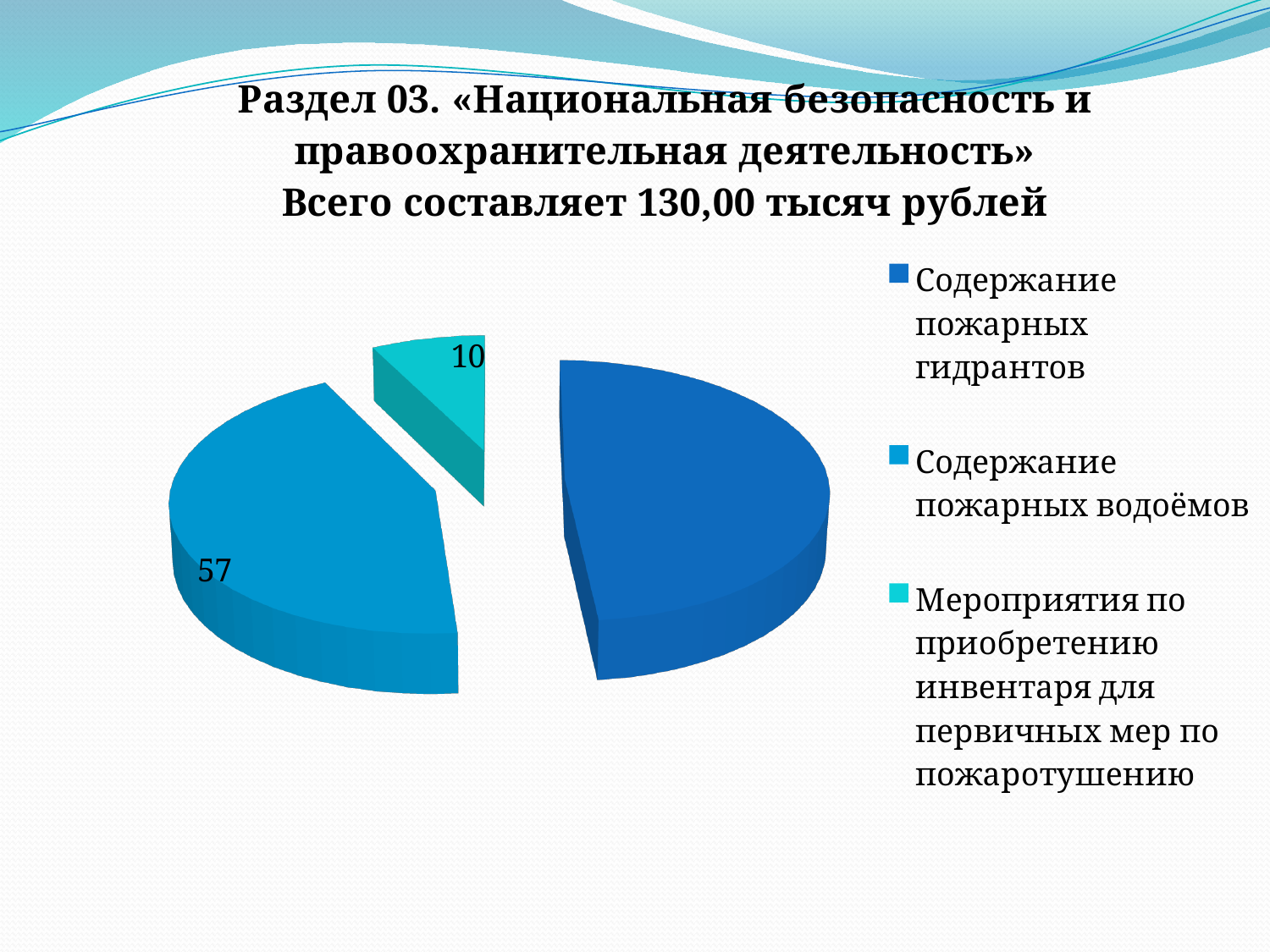
What is the value shown for Содержание пожарных водоёмов? 57 Which is larger: the slice for Содержание пожарных гидрантов or the slice for Мероприятия по приобретению инвентаря для первичных мер по пожаротушению? Содержание пожарных гидрантов What is the value shown for Мероприятия по приобретению инвентаря для первичных мер по пожаротушению? 10 How many entries does the legend list? 3 According to the slide title, what is the total amount for Раздел 03? 130,00 тысяч рублей What colour is the slice for Содержание пожарных гидрантов? dark blue What is the difference between the values for Содержание пожарных водоёмов and Мероприятия по приобретению инвентаря для первичных мер по пожаротушению? 47 How many slices does the pie chart have? 3 What kind of chart is shown on the slide? pie chart Which category has the smallest slice of the pie? Мероприятия по приобретению инвентаря для первичных мер по пожаротушению Which is larger: the slice for Содержание пожарных водоёмов or the slice for Мероприятия по приобретению инвентаря для первичных мер по пожаротушению? Содержание пожарных водоёмов